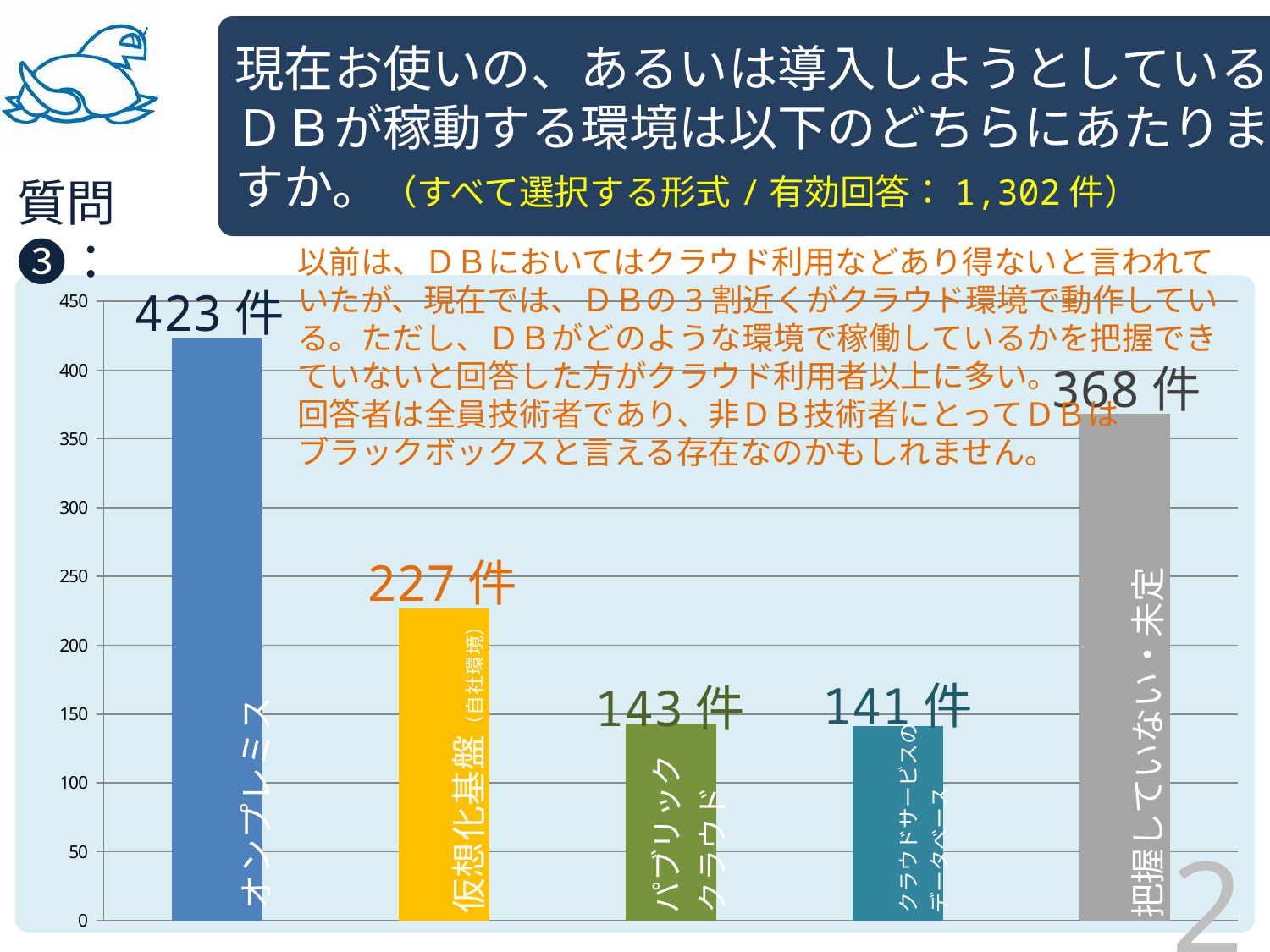
Is the value for 把握していない・未定 greater or less than 350? greater What type of chart is shown on the slide? bar chart What is the maximum value shown on the vertical axis? 450 Which category has the lowest value? クラウドサービスのデータベース How many bars (categories) does the chart show? 5 What is the value for オンプレミス? 423 件 What is the difference between the values for オンプレミス and 把握していない・未定? 55 件 What is the value for 仮想化基盤（自社環境）? 227 件 Which category has the highest value? オンプレミス Which is larger, the value for 仮想化基盤（自社環境） or the value for パブリッククラウド? 仮想化基盤（自社環境） What is the value for 把握していない・未定? 368 件 What is the value for パブリッククラウド? 143 件